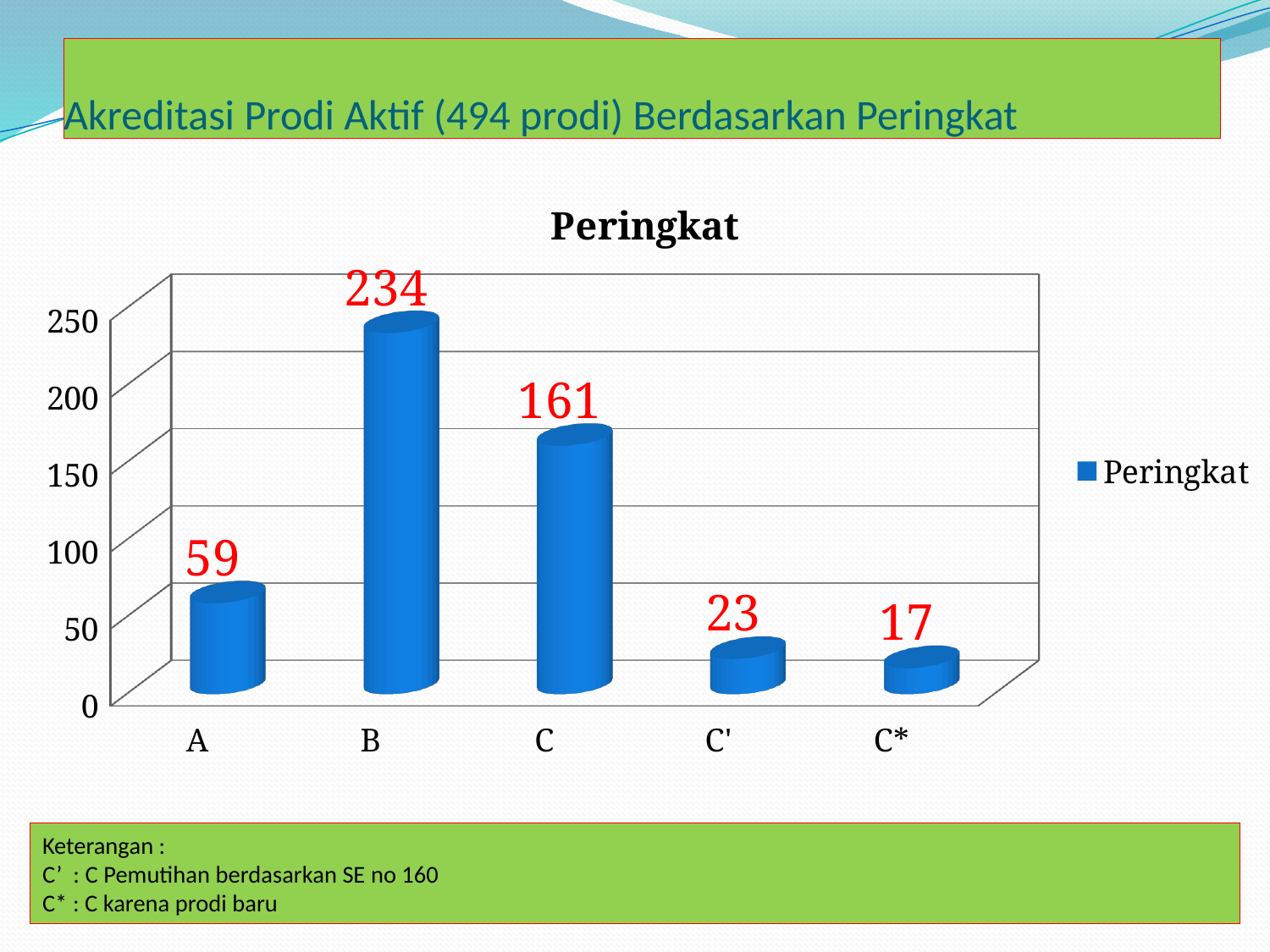
Which is larger, the value for A or the value for C'? A Which category has the lowest value? C* What kind of chart is shown on the slide? bar chart What is the value for category B? 234 What is the difference between the values for A and C*? 42 What is the difference between the values for B and C? 73 What is the title of the chart? Peringkat Is the value for C greater or less than 150? greater How many categories are shown on the x axis? 5 What is the value for category C'? 23 Which category has the highest value? B What is the value for category A? 59